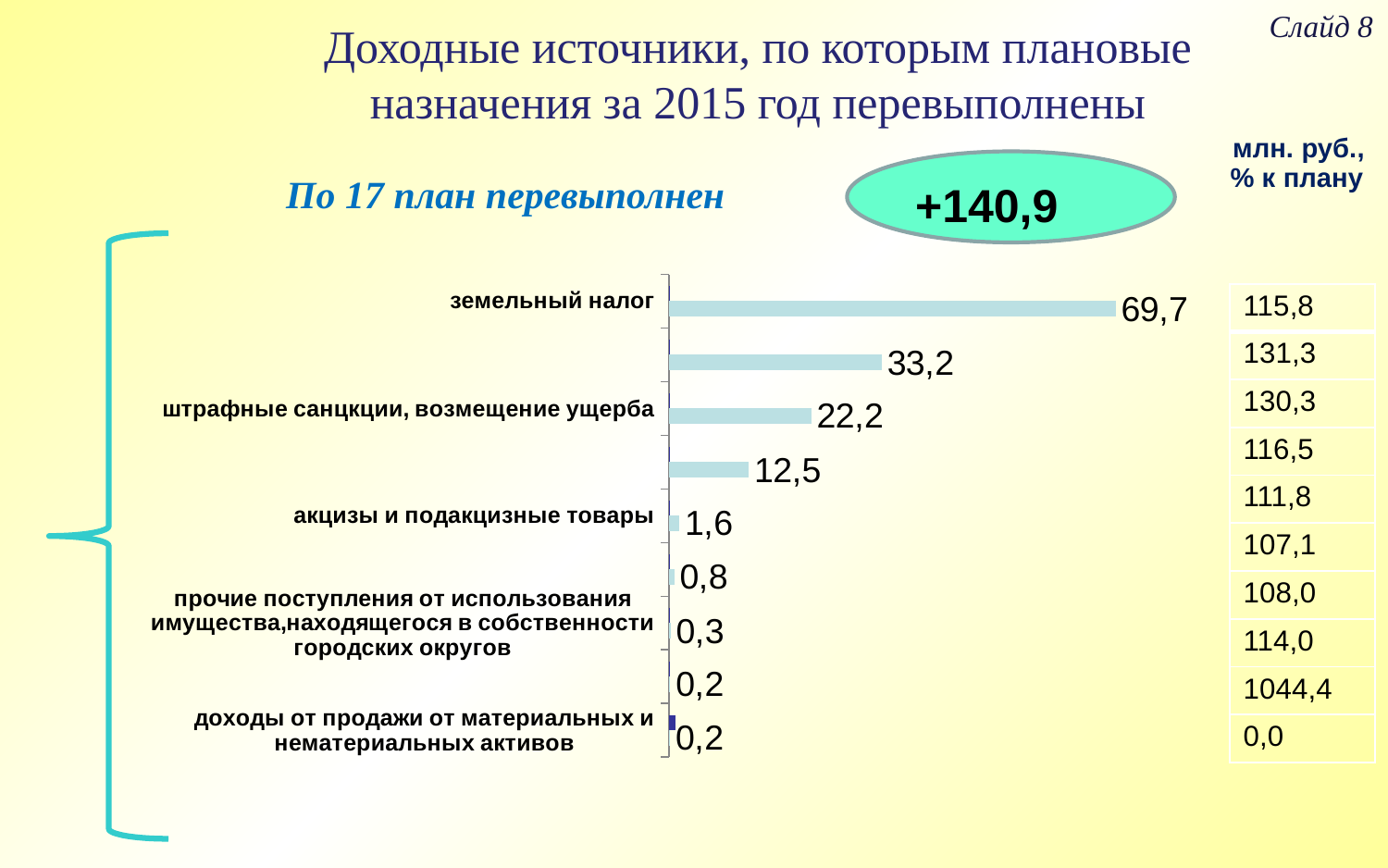
Do the bar values increase or decrease from the top of the chart to the bottom? decrease What is the value for штрафные санкции, возмещение ущерба? 22,2 How many bars are plotted in the chart? 9 Which is larger: the value for земельный налог or the value for штрафные санкции, возмещение ущерба? земельный налог What is the value for земельный налог? 69,7 Which category has the highest value in the chart? земельный налог What kind of chart is shown on the slide? bar chart What is the difference between the values for земельный налог and штрафные санкции, возмещение ущерба? 47,5 What is the difference between the values for штрафные санкции, возмещение ущерба and акцизы и подакцизные товары? 20,6 What is the value for акцизы и подакцизные товары? 1,6 What is the value for доходы от продажи от материальных и нематериальных активов? 0,2 What is the largest value shown on the chart? 69,7